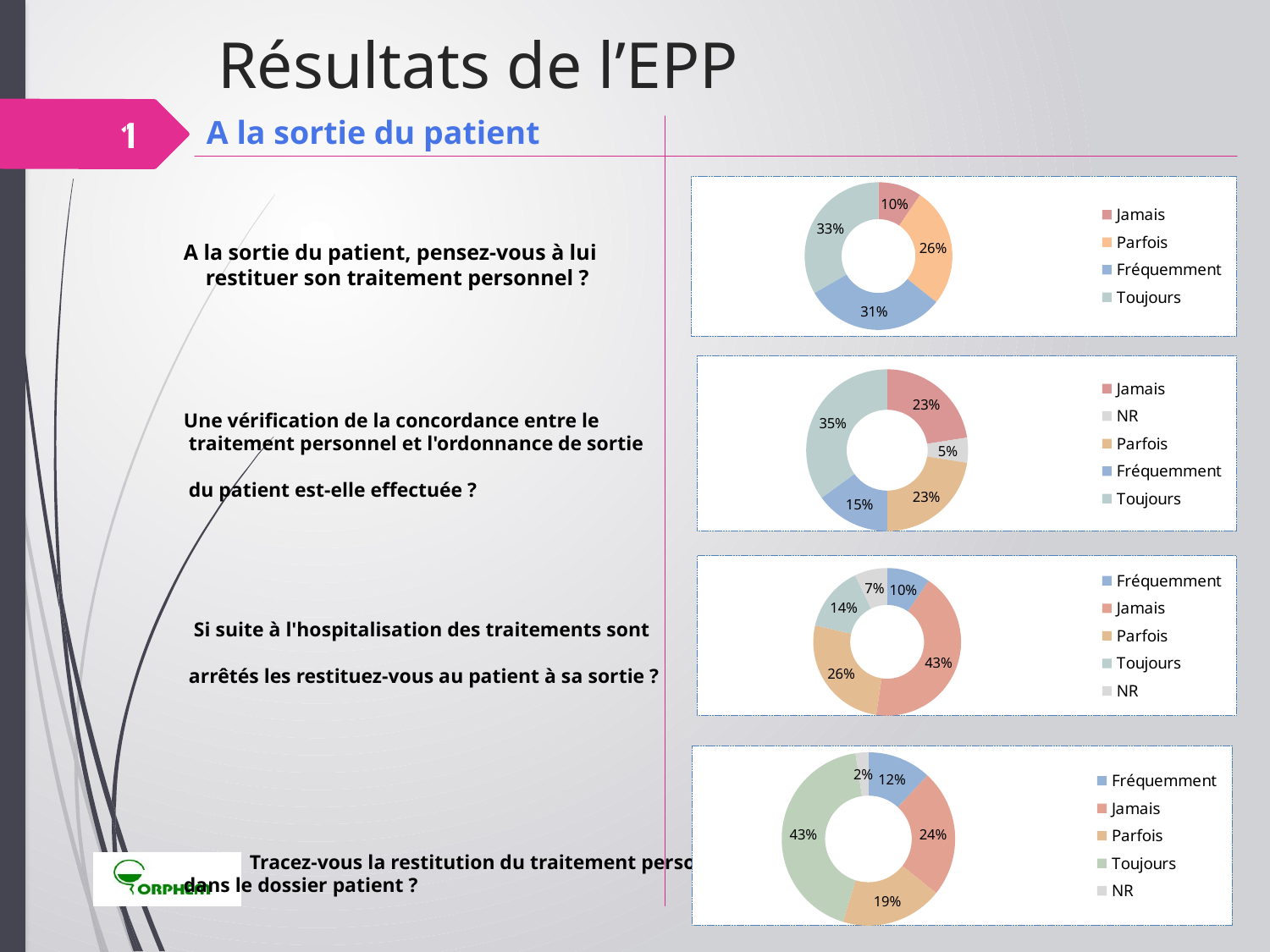
In the top chart (next to 'A la sortie du patient, pensez-vous à lui restituer son traitement personnel ?'), what share is labelled for Toujours? 33% In the third chart from the top (treatments stopped after hospitalisation), what share is labelled for Jamais? 43% What type of chart is used for the four charts on the slide? Doughnut chart In the second chart from the top (concordance between personal treatment and discharge prescription), what share is labelled for NR? 5% In the bottom chart (tracing the restitution in the patient file), what share is labelled for Toujours? 43% In the bottom chart, which category has the smallest share? NR In the second chart from the top, what is the difference between the Toujours share and the Fréquemment share? 20% In the top chart, which category has the smallest share? Jamais In the third chart from the top, which is larger, the Parfois share or the Toujours share? Parfois In the third chart from the top, how many categories are shown in the legend? 5 In the top chart, how many entries does the legend list? 4 In the second chart from the top, which category has the largest share? Toujours